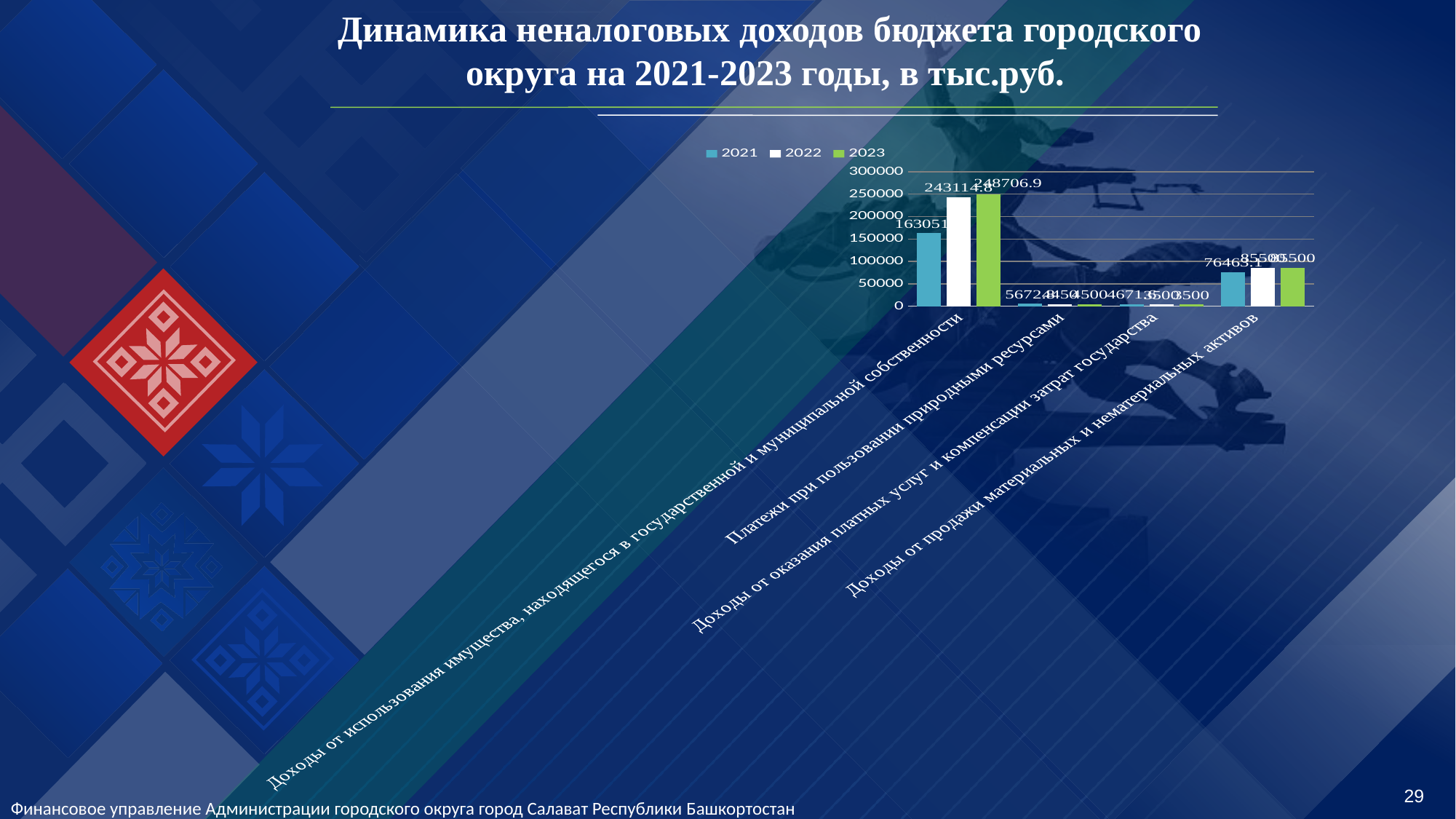
What kind of chart is shown on the slide? bar chart What is the 2021 value for "Доходы от использования имущества, находящегося в государственной и муниципальной собственности"? 163051.1 What is the 2021 value for "Доходы от продажи материальных и нематериальных активов"? 76463.1 How many series does the legend list? 3 For "Доходы от использования имущества, находящегося в государственной и муниципальной собственности", which year has the larger value, 2021 or 2023? 2023 Is the 2022 value for "Доходы от продажи материальных и нематериальных активов" greater or less than 50000? greater What is the difference between the 2023 and 2021 values for "Доходы от использования имущества, находящегося в государственной и муниципальной собственности"? 85655.8 What entries does the legend list? 2021, 2022, 2023 Which category has the highest values across all years? Доходы от использования имущества, находящегося в государственной и муниципальной собственности How many categories are shown on the x axis? 4 What is the 2023 value for "Доходы от использования имущества, находящегося в государственной и муниципальной собственности"? 248706.9 What is the 2022 value for "Доходы от использования имущества, находящегося в государственной и муниципальной собственности"? 243114.8